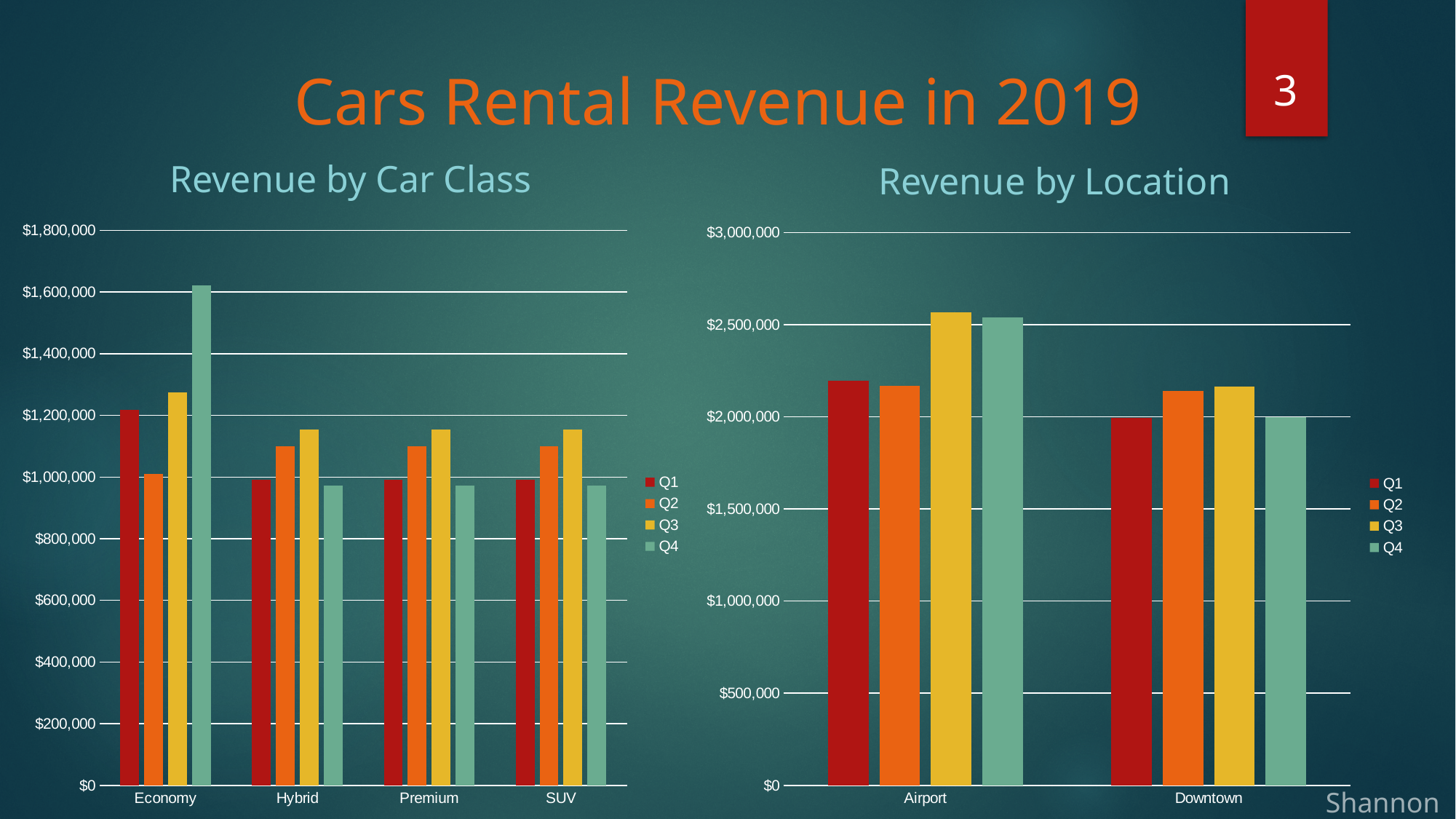
In the "Revenue by Location" chart, is the Q2 value for Downtown greater or less than $2,500,000? less In the "Revenue by Location" chart, which location has the higher Q3 bar? Airport In the "Revenue by Location" chart, which is larger: the Q1 value for Airport or the Q1 value for Downtown? Airport How many car classes are shown on the x axis of the "Revenue by Car Class" chart? 4 In the "Revenue by Location" chart, is the Q3 value for Airport greater or less than $2,500,000? greater In the "Revenue by Car Class" chart, is the Q4 value for Economy greater or less than $1,400,000? greater How many series does the legend of the "Revenue by Location" chart list? 4 What kind of chart is the "Revenue by Car Class" chart? bar chart In the "Revenue by Car Class" chart, which car class has the highest Q4 bar? Economy In the "Revenue by Car Class" chart, which is larger: the Q3 value for Economy or the Q3 value for Hybrid? Economy How many locations are shown on the x axis of the "Revenue by Location" chart? 2